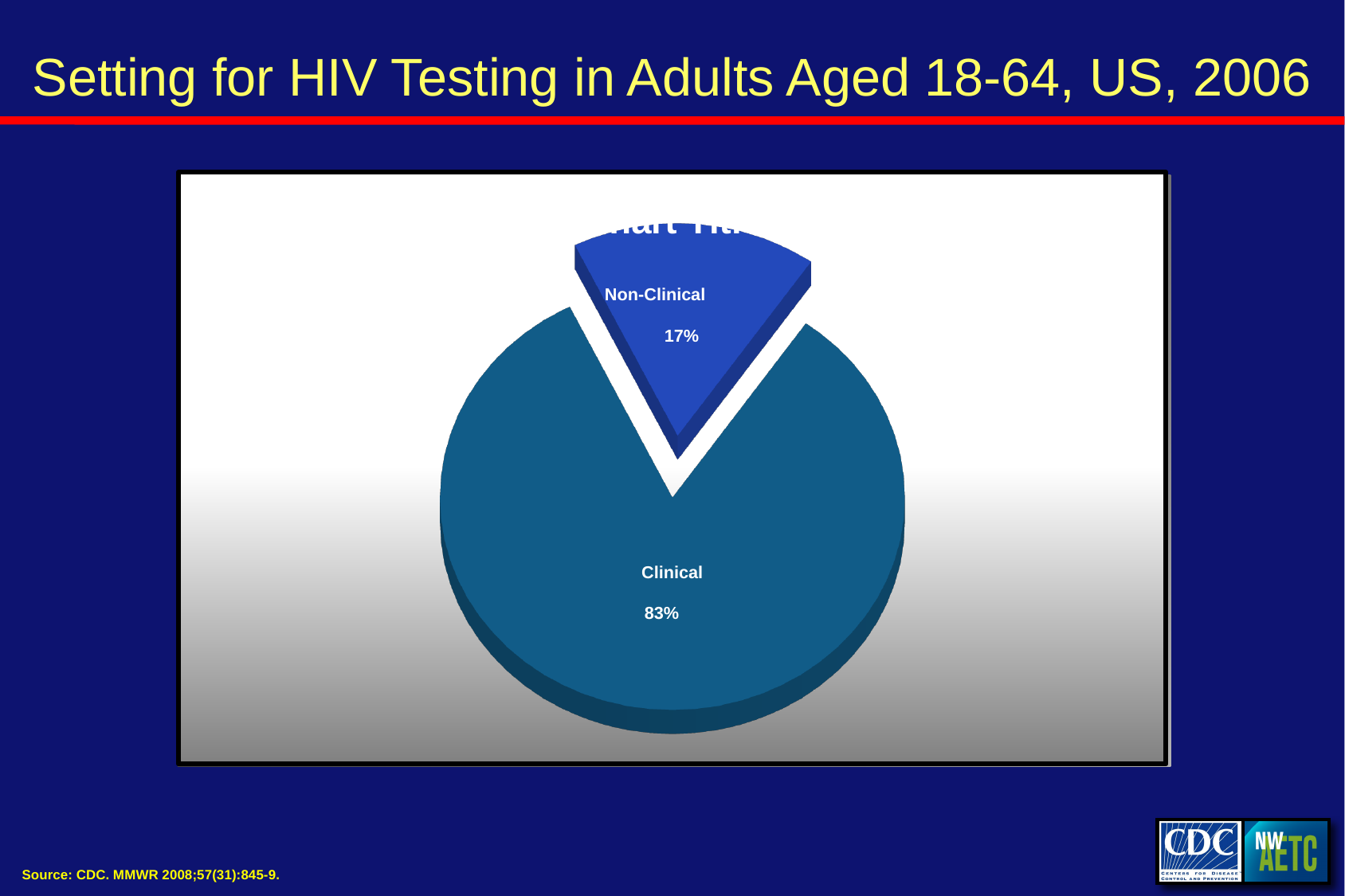
What share of the pie does the Non-Clinical slice represent? 17% What percentage of HIV testing took place in a Non-Clinical setting? 17% What is the difference in percentage points between the Clinical and Non-Clinical shares? 66 Which slice is pulled out (exploded) from the pie? Non-Clinical Which setting accounts for the smallest share of the pie? Non-Clinical Which is larger, the Clinical share or the Non-Clinical share? Clinical What percentage of HIV testing took place in a Clinical setting? 83% What is the title of the slide containing the pie chart? Setting for HIV Testing in Adults Aged 18-64, US, 2006 Which setting accounts for the largest share of the pie? Clinical How many slices does the pie chart have? 2 What kind of chart is shown on the slide? pie chart